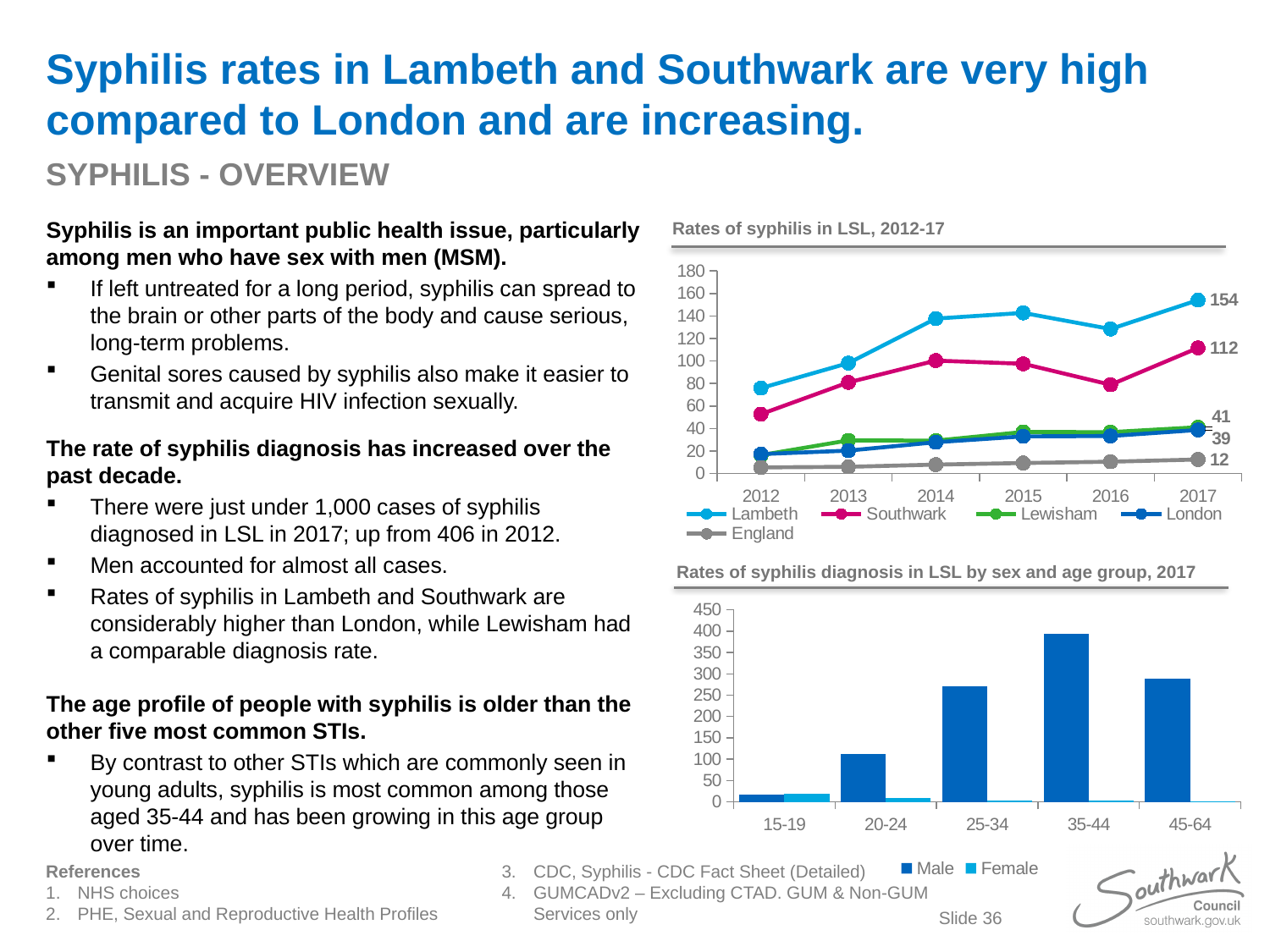
In the chart 'Rates of syphilis in LSL, 2012-17', how many years are shown on the x axis? 6 In the chart 'Rates of syphilis in LSL, 2012-17', what is the value for Southwark in 2017? 112 In the chart 'Rates of syphilis in LSL, 2012-17', does the Lambeth line rise or fall overall from 2012 to 2017? rise In the chart 'Rates of syphilis diagnosis in LSL by sex and age group, 2017', which age group has the highest Male value? 35-44 In the chart 'Rates of syphilis in LSL, 2012-17', which is larger in 2017: Lambeth or Southwark? Lambeth In the chart 'Rates of syphilis diagnosis in LSL by sex and age group, 2017', is the Male value for 35-44 greater or less than 350? greater In the chart 'Rates of syphilis diagnosis in LSL by sex and age group, 2017', how many series does the legend list? 2 In the chart 'Rates of syphilis in LSL, 2012-17', how many series does the legend list? 5 What kind of chart is 'Rates of syphilis diagnosis in LSL by sex and age group, 2017'? bar chart In the chart 'Rates of syphilis in LSL, 2012-17', what is the difference between the Lambeth and Southwark values in 2017? 42 In the chart 'Rates of syphilis in LSL, 2012-17', what is the value for England in 2017? 12 In the chart 'Rates of syphilis in LSL, 2012-17', what is the value for Lambeth in 2017? 154